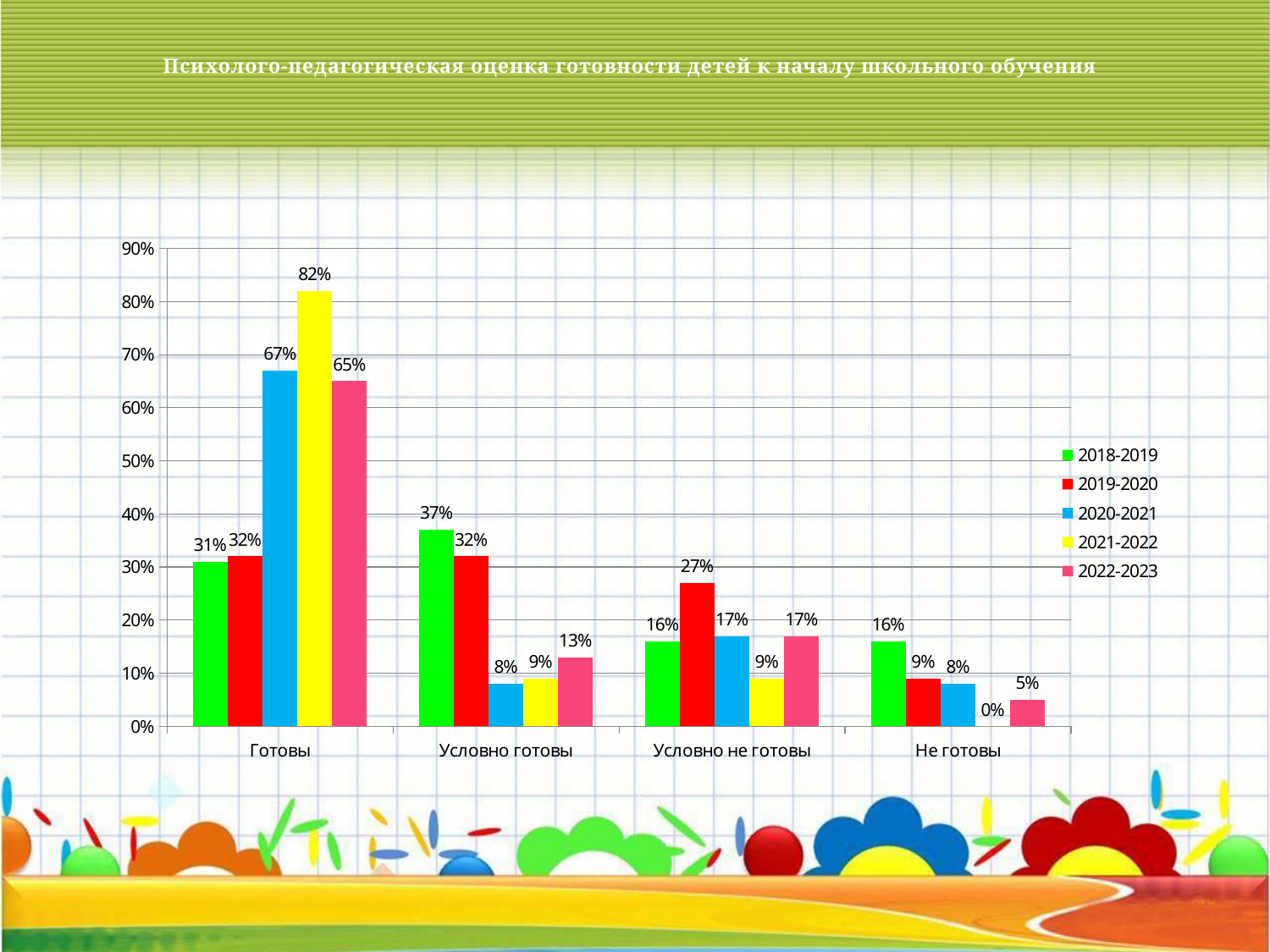
How many series does the legend list? 5 What is the value for 2022-2023 in the Не готовы category? 5% What is the difference between the 2021-2022 and 2020-2021 values in the Готовы category? 15% What colour represents the 2020-2021 series in the legend? blue What is the value for 2021-2022 in the Готовы category? 82% What is the value for 2019-2020 in the Условно не готовы category? 27% What kind of chart is shown on the slide? bar chart Is the value for 2022-2023 in the Готовы category greater or less than 60%? greater Which series has the highest value in the Готовы category? 2021-2022 Which series has the lowest value in the Не готовы category? 2021-2022 Which is larger in the Условно готовы category: the value for 2018-2019 or for 2019-2020? 2018-2019 How many categories are shown on the x axis? 4